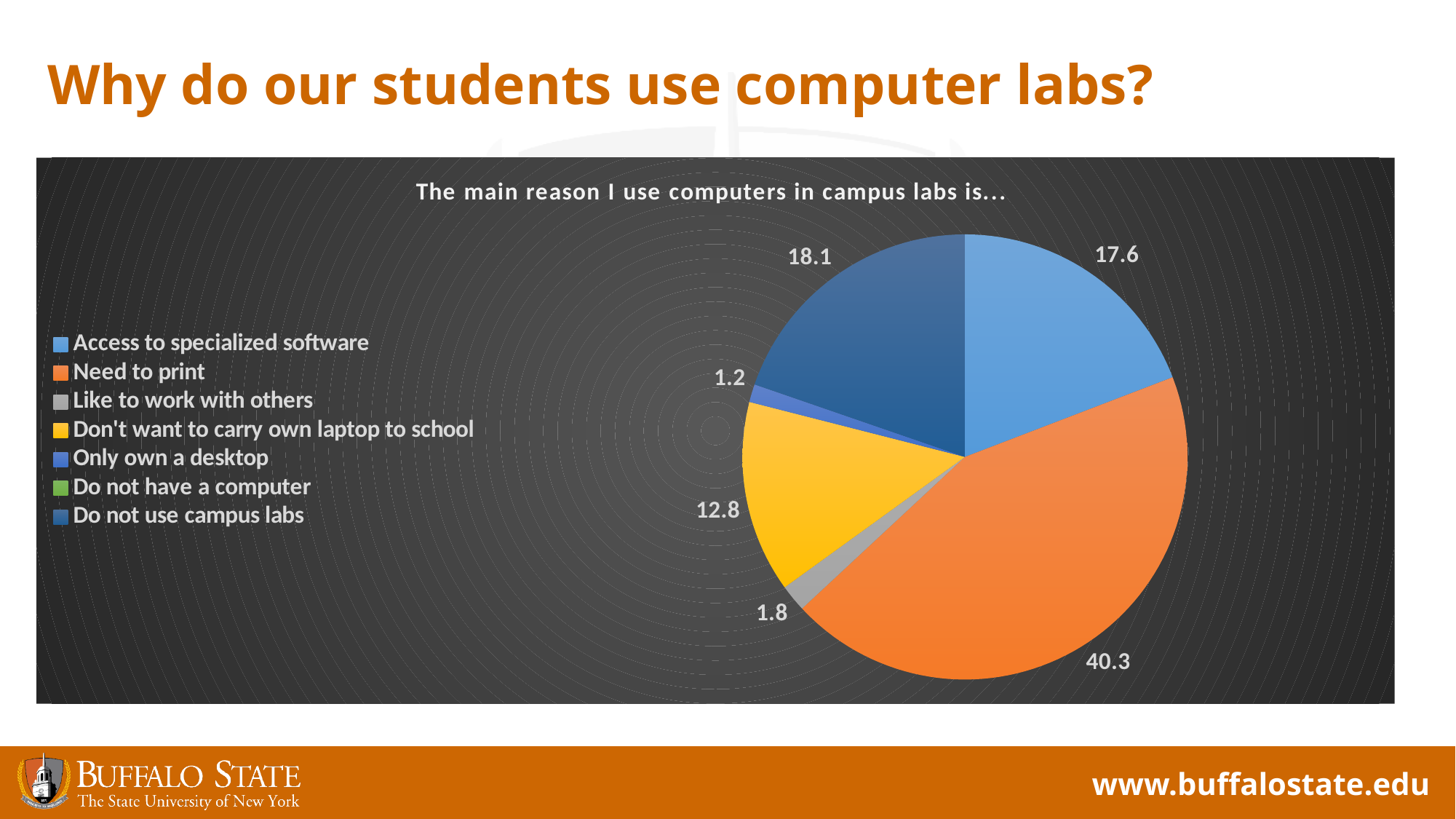
What is the value for "Do not use campus labs"? 18.1 Which of the labelled slices has the smallest value? Only own a desktop What is the value for "Like to work with others"? 1.8 What is the value for "Don't want to carry own laptop to school"? 12.8 What is the value for "Only own a desktop"? 1.2 Which reason has the largest slice of the pie? Need to print What is the difference between the values for "Need to print" and "Do not use campus labs"? 22.2 How many categories does the legend list? 7 What is the value for "Need to print"? 40.3 Which is larger: "Do not use campus labs" or "Access to specialized software"? Do not use campus labs What is the value for "Access to specialized software"? 17.6 What type of chart is shown on the slide? Pie chart